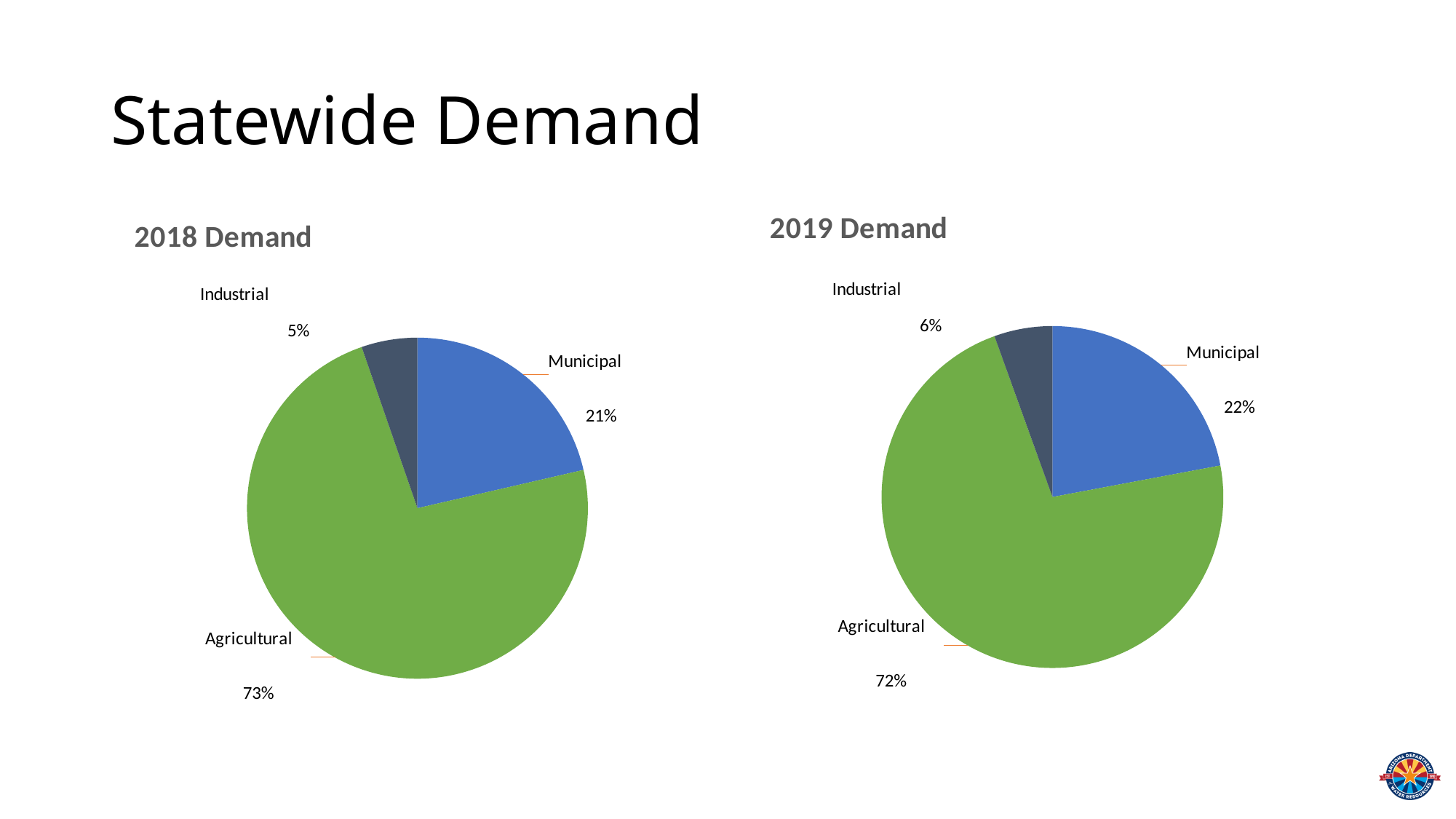
In the 2018 Demand chart, which is larger, Municipal or Industrial? Municipal In the 2019 Demand chart, what colour is the Agricultural slice? Green In the 2018 Demand chart, what share does Agricultural have? 73% In the 2018 Demand chart, what is the difference between the Agricultural and Municipal shares? 52% How many categories does the 2019 Demand chart show? 3 In the 2018 Demand chart, which category has the largest share? Agricultural In the 2018 Demand chart, what is the value for Industrial? 5% In the 2019 Demand chart, what is the difference between the Municipal and Industrial shares? 16% In the 2019 Demand chart, what is the value for Industrial? 6% In the 2019 Demand chart, which category has the smallest share? Industrial What kind of chart is the 2018 Demand chart? Pie chart In the 2019 Demand chart, what share does Municipal have? 22%